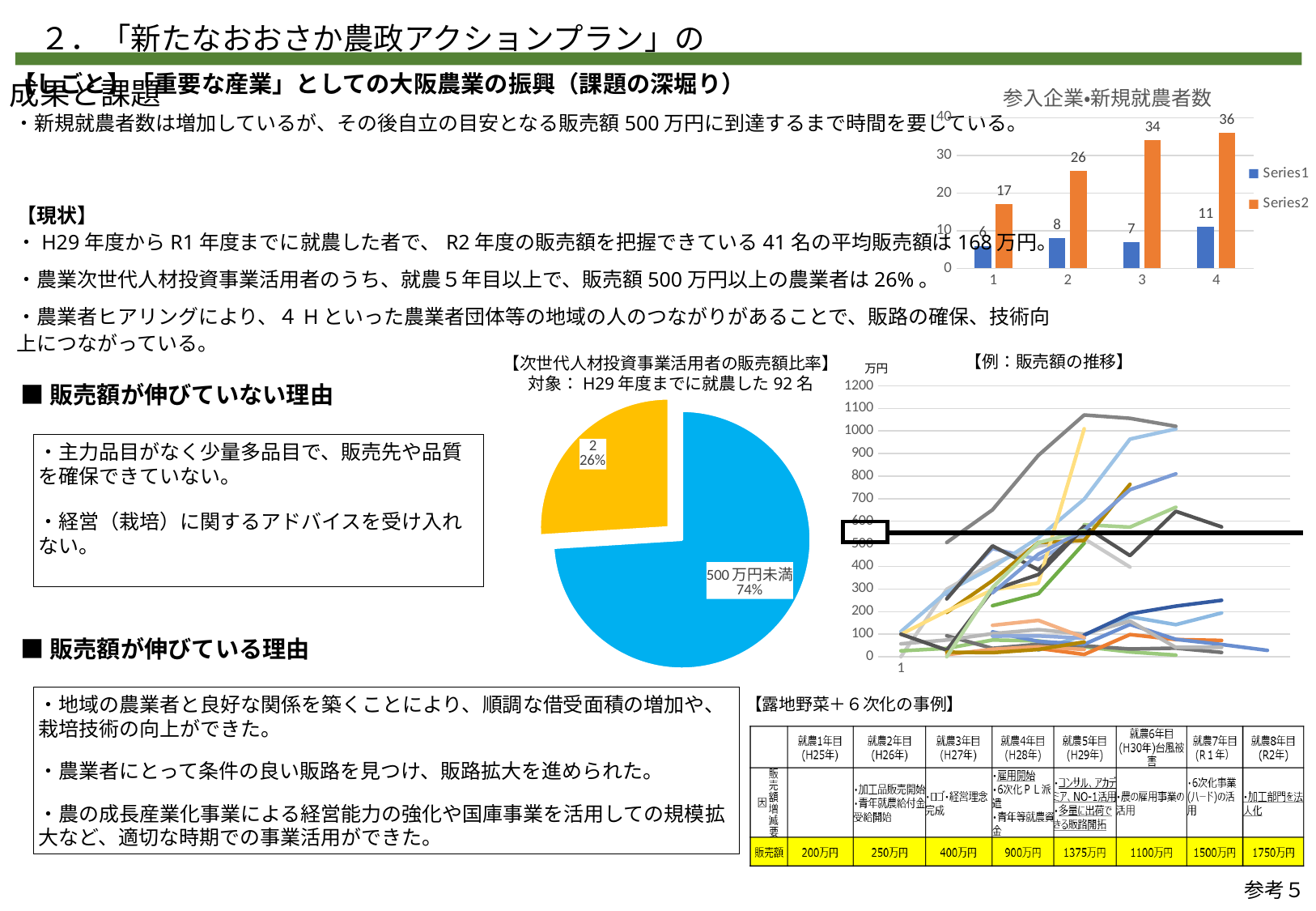
In the bar chart titled 参入企業•新規就農者数, how many series does the legend list? 2 In the bar chart titled 参入企業•新規就農者数, do the Series2 values rise or fall from category 1 to category 4? rise In the bar chart titled 参入企業•新規就農者数, what is the value of Series1 for category 2? 8 In the bar chart titled 参入企業•新規就農者数, which is larger: Series1 for category 4 or Series1 for category 3? Series1 for category 4 In the bar chart titled 参入企業•新規就農者数, what is the value of Series2 for category 4? 36 In the bar chart titled 参入企業•新規就農者数, which category has the highest Series2 value? 4 What kind of chart is the chart titled 例：販売額の推移? line chart In the bar chart titled 参入企業•新規就農者数, which category has the lowest Series1 value? 1 In the pie chart titled 次世代人材投資事業活用者の販売額比率, how many slices are there? 2 In the bar chart titled 参入企業•新規就農者数, what is the difference between the Series2 values for category 3 and category 1? 17 In the bar chart titled 参入企業•新規就農者数, how many categories are shown on the x axis? 4 In the pie chart titled 次世代人材投資事業活用者の販売額比率, what share does the 500万円未満 slice represent? 74%